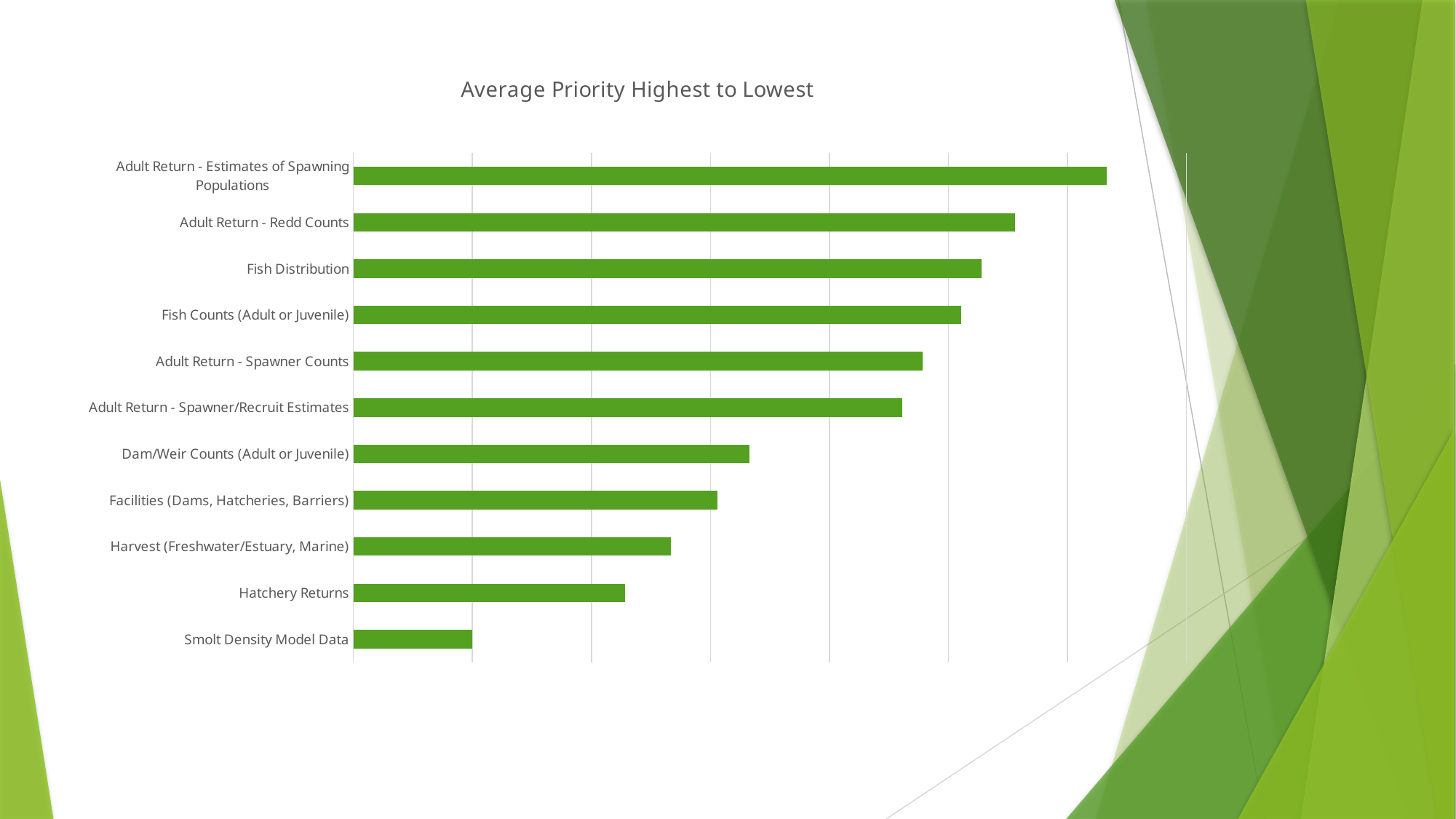
Do the bar values rise or fall going from the top category to the bottom category? fall Which category has the second-highest average priority? Adult Return - Redd Counts How many categories are plotted in the chart? 11 Which has the larger value, Fish Distribution or Hatchery Returns? Fish Distribution Which has the larger value, Adult Return - Redd Counts or Fish Counts (Adult or Juvenile)? Adult Return - Redd Counts What colour are the bars in the chart? green What kind of chart is shown on the slide? bar chart Which has the larger value, Dam/Weir Counts (Adult or Juvenile) or Facilities (Dams, Hatcheries, Barriers)? Dam/Weir Counts (Adult or Juvenile) What is the title of the chart? Average Priority Highest to Lowest Which category has the highest average priority? Adult Return - Estimates of Spawning Populations Which category has the lowest average priority? Smolt Density Model Data